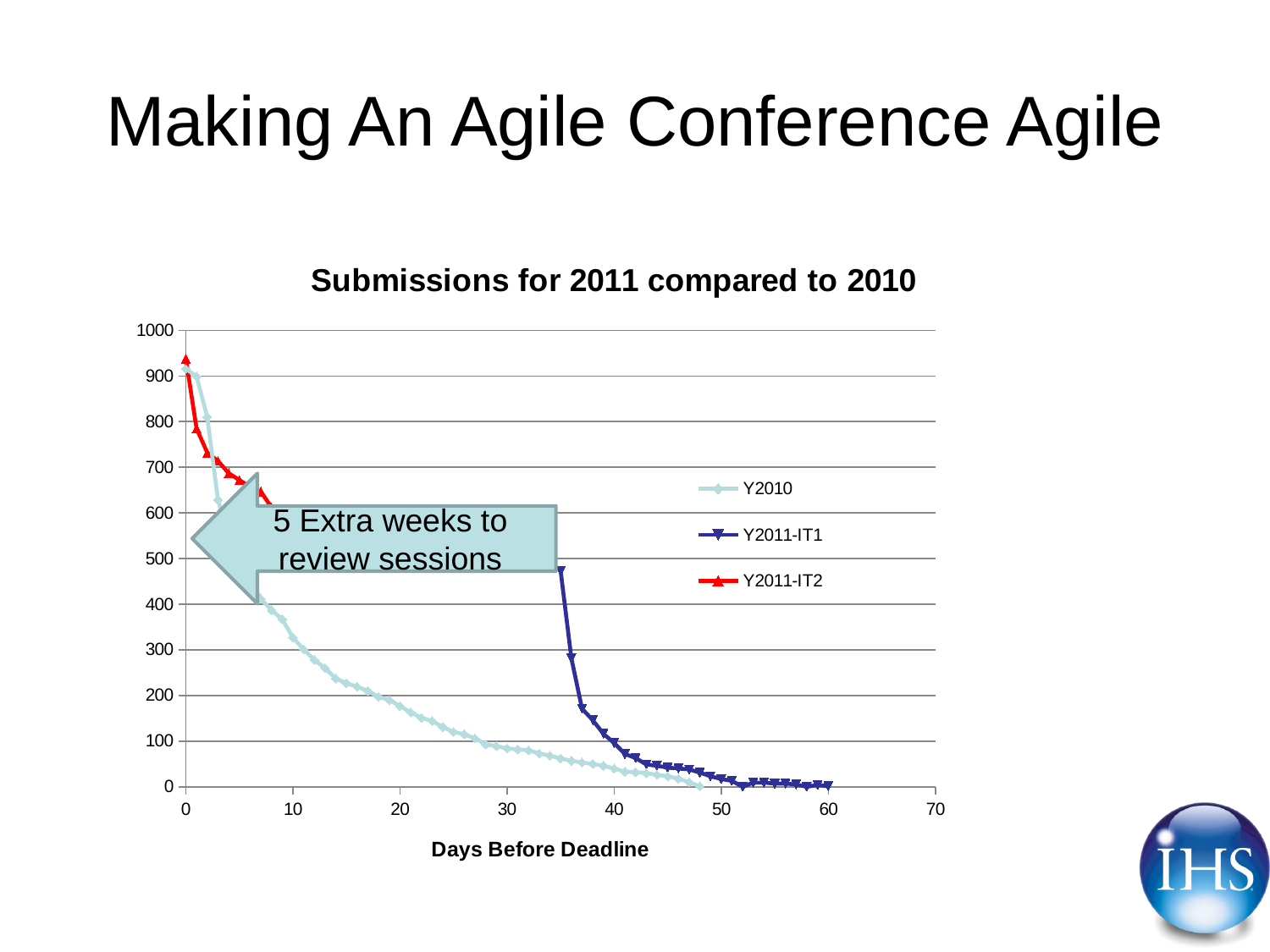
Do the values of the Y2010 series rise or fall as Days Before Deadline increases? Fall What is the label of the x axis of the chart? Days Before Deadline What kind of chart is shown on the slide? Line chart Is the value of the Y2011-IT2 series at 2 days before deadline greater or less than 700? greater Which series extends furthest along the x axis (to the most days before deadline)? Y2011-IT1 Is the value of the Y2011-IT2 series at 0 days before deadline greater or less than 900? greater Is the value of the Y2011-IT1 series at 45 days before deadline greater or less than 100? less How many series does the legend of the chart list? 3 At 5 days before deadline, which series has the larger value, Y2010 or Y2011-IT2? Y2011-IT2 What is the title of the chart? Submissions for 2011 compared to 2010